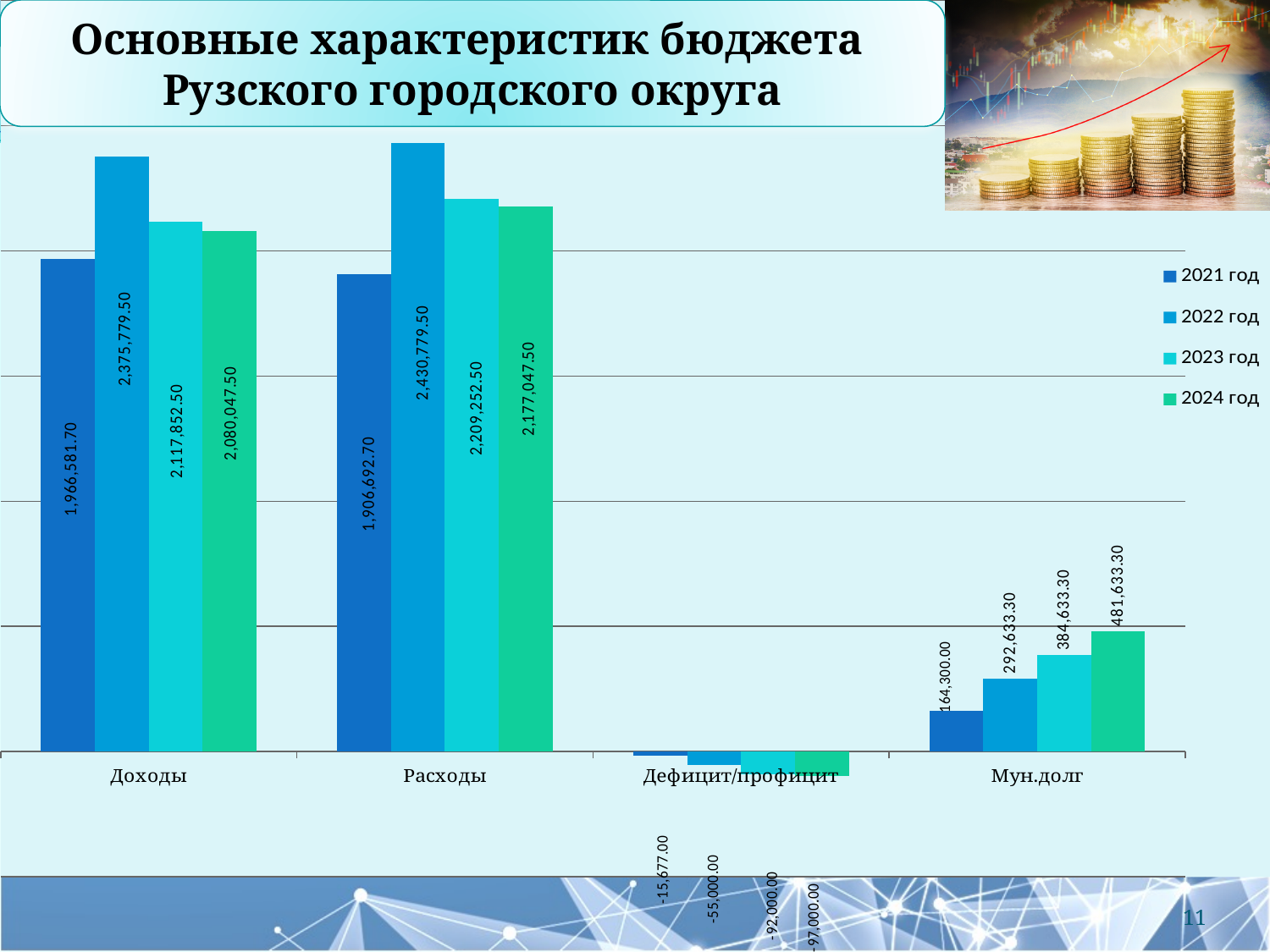
Which year has the lowest value for Мун.долг? 2021 год What is the value for Мун.долг in 2021 год? 164,300.00 Which year has the highest value for Расходы? 2022 год Do the Мун.долг values rise or fall from 2021 год to 2024 год? rise What is the value for Дефицит/профицит in 2023 год? -92,000.00 Which is larger: Доходы in 2023 год or Доходы in 2024 год? Доходы in 2023 год What is the difference between the Мун.долг values for 2024 год and 2021 год? 317,333.30 What is the difference between Расходы and Доходы in 2022 год? 55,000.00 How many series does the legend list? 4 How many categories are shown on the x axis? 4 What is the value for Расходы in 2024 год? 2,177,047.50 What is the value for Доходы in 2022 год? 2,375,779.50